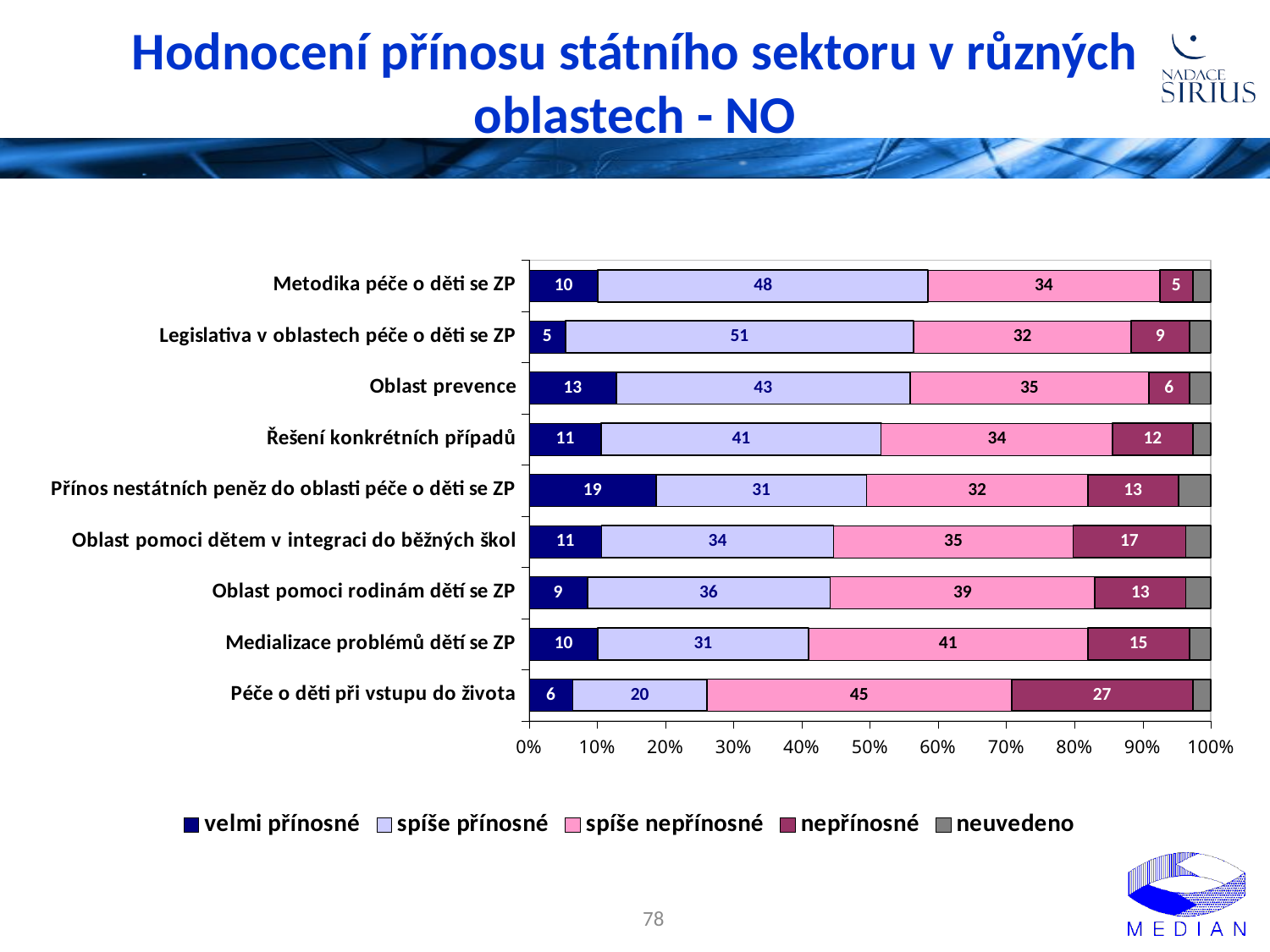
Which category has the highest value for "nepřínosné"? Péče o děti při vstupu do života What is the difference between the "spíše nepřínosné" values for "Péče o děti při vstupu do života" and "Medializace problémů dětí se ZP"? 4 What is the value for "spíše nepřínosné" for "Oblast pomoci rodinám dětí se ZP"? 39 Which category has the lowest value for "spíše přínosné"? Péče o děti při vstupu do života How many series does the legend list? 5 What is the value for "nepřínosné" for "Péče o děti při vstupu do života"? 27 What kind of chart is shown on the slide? Stacked bar chart Which has the larger "spíše přínosné" value: "Metodika péče o děti se ZP" or "Oblast prevence"? Metodika péče o děti se ZP How many categories are shown on the chart? 9 Which category has the highest value for "velmi přínosné"? Přínos nestátních peněz do oblasti péče o děti se ZP What is the value for "velmi přínosné" for "Přínos nestátních peněz do oblasti péče o děti se ZP"? 19 What is the value for "spíše přínosné" for "Legislativa v oblastech péče o děti se ZP"? 51